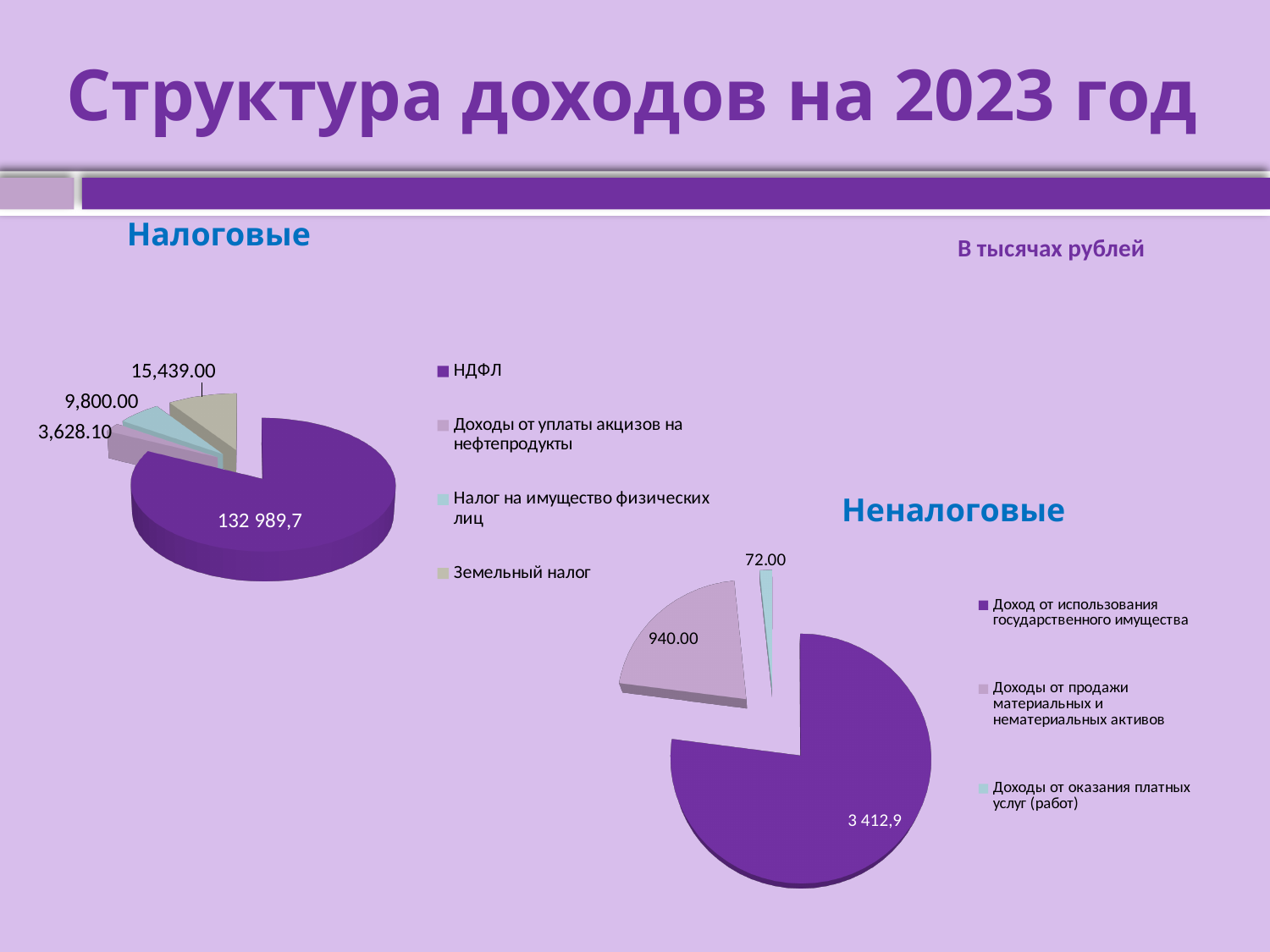
In the "Неналоговые" pie chart, what is the value for Доход от использования государственного имущества? 3 412,9 What type of chart is used for "Налоговые"? Pie chart In the "Налоговые" pie chart, what is the value for Доходы от уплаты акцизов на нефтепродукты? 3,628.10 In the "Неналоговые" pie chart, what is the value for Доходы от оказания платных услуг (работ)? 72.00 In the "Налоговые" pie chart, which category has the smallest value? Доходы от уплаты акцизов на нефтепродукты How many categories does the "Неналоговые" pie chart show? 3 In the "Налоговые" pie chart, what is the value for Налог на имущество физических лиц? 9,800.00 In the "Неналоговые" pie chart, what is the difference between Доходы от продажи материальных и нематериальных активов and Доходы от оказания платных услуг (работ)? 868.00 In the "Налоговые" pie chart, what is the value for Земельный налог? 15,439.00 In the "Налоговые" pie chart, what is the difference between Земельный налог and Налог на имущество физических лиц? 5,639.00 In the "Неналоговые" pie chart, which category has the largest value? Доход от использования государственного имущества In the "Налоговые" pie chart, what is the value for НДФЛ? 132 989,7